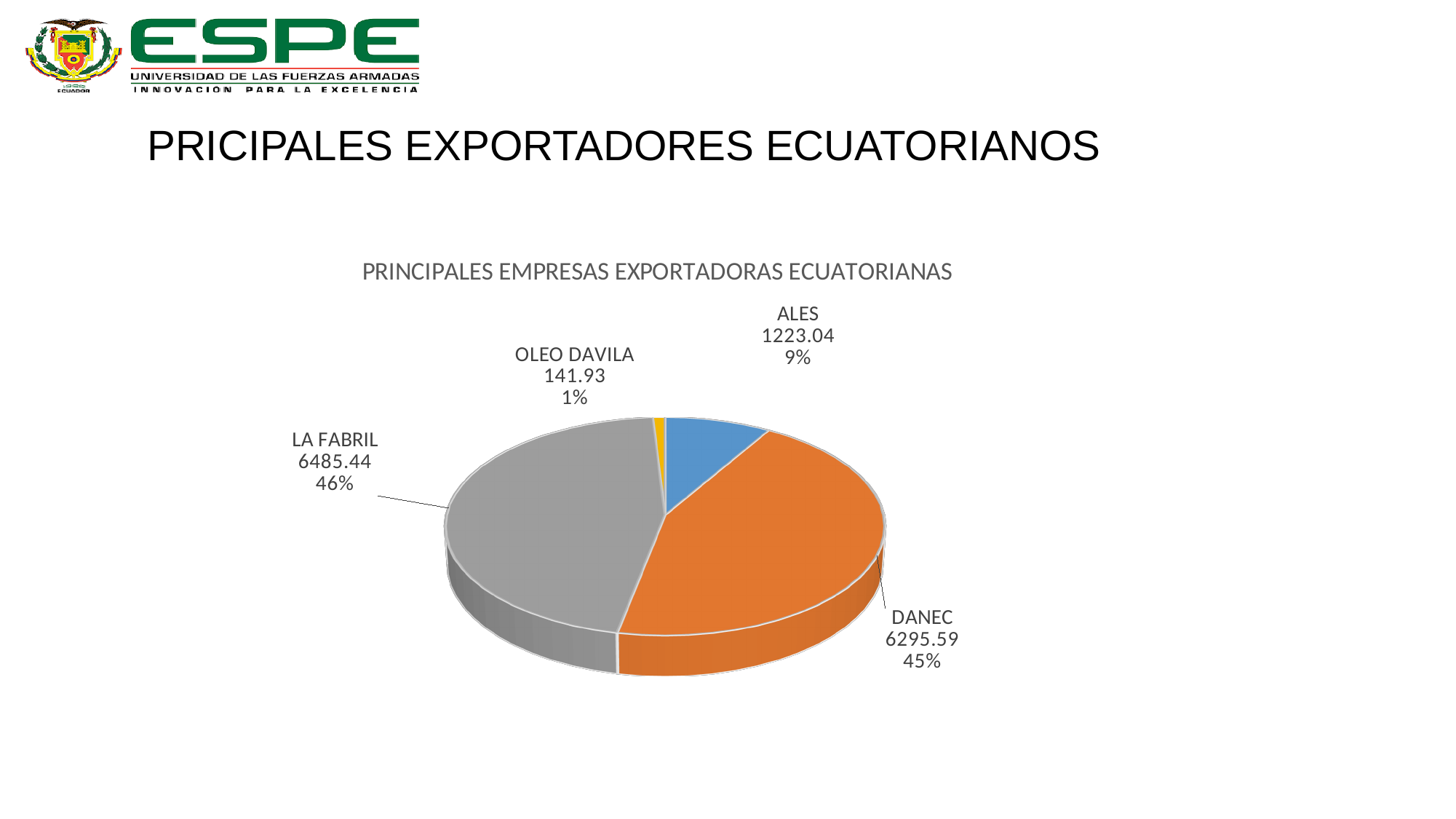
What share of the pie does ALES represent? 9% What kind of chart is shown on the slide? Pie chart What is the title of the chart? PRINCIPALES EMPRESAS EXPORTADORAS ECUATORIANAS How many slices does the pie chart have? 4 What is the value shown for LA FABRIL? 6485.44 What share of the pie does LA FABRIL represent? 46% What is the value shown for DANEC? 6295.59 What is the value shown for ALES? 1223.04 What is the difference between the values for LA FABRIL and DANEC? 189.85 Which company has the largest slice of the pie? LA FABRIL What is the value shown for OLEO DAVILA? 141.93 Which company has the smallest slice of the pie? OLEO DAVILA